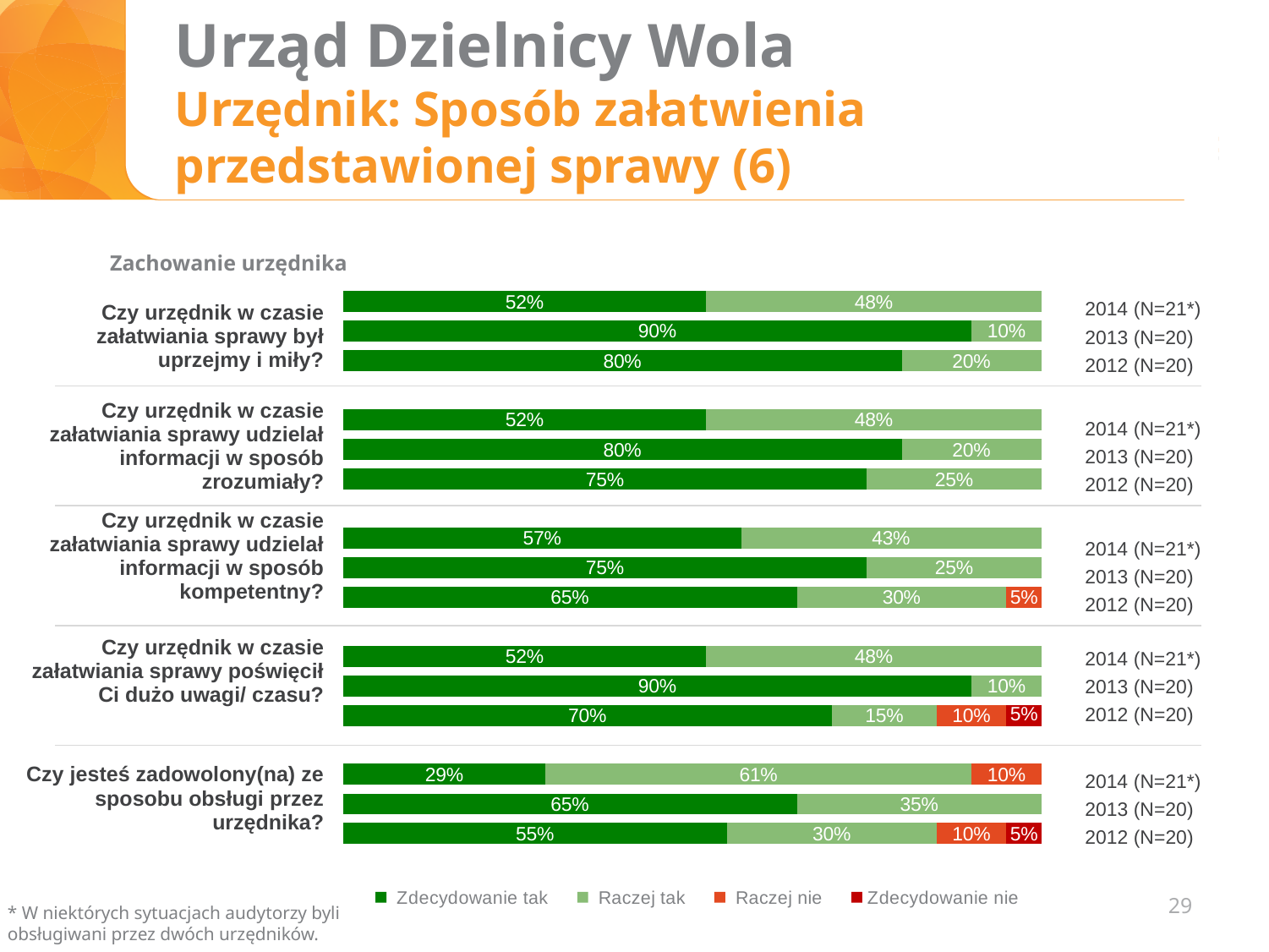
What type of chart is shown on the slide? Stacked bar chart Which legend entry is shown in dark red? Zdecydowanie nie What percentage of respondents answered "Zdecydowanie tak" in 2013 to the question "Czy urzędnik w czasie załatwiania sprawy był uprzejmy i miły?" 90% What is the "Raczej tak" value for 2014 (N=21*) for the question "Czy jesteś zadowolony(na) ze sposobu obsługi przez urzędnika?" 61% For the question "Czy jesteś zadowolony(na) ze sposobu obsługi przez urzędnika?", which year has the lowest "Zdecydowanie tak" share? 2014 (N=21*) How many survey questions (bar groups) are shown on the chart? 5 How many series does the legend list? 4 For the question "Czy urzędnik w czasie załatwiania sprawy udzielał informacji w sposób zrozumiały?", what is the difference between the "Zdecydowanie tak" values for 2013 and 2014? 28 percentage points For the question "Czy urzędnik w czasie załatwiania sprawy udzielał informacji w sposób kompetentny?", which year has the highest "Zdecydowanie tak" share? 2013 (N=20) What is the "Zdecydowanie nie" value for 2012 for the question "Czy urzędnik w czasie załatwiania sprawy poświęcił Ci dużo uwagi/ czasu?" 5% For the question "Czy urzędnik w czasie załatwiania sprawy był uprzejmy i miły?", is the "Zdecydowanie tak" share larger in 2012 or in 2014? 2012 For the question "Czy urzędnik w czasie załatwiania sprawy poświęcił Ci dużo uwagi/ czasu?", what is the combined share of "Raczej nie" and "Zdecydowanie nie" in 2012? 15%